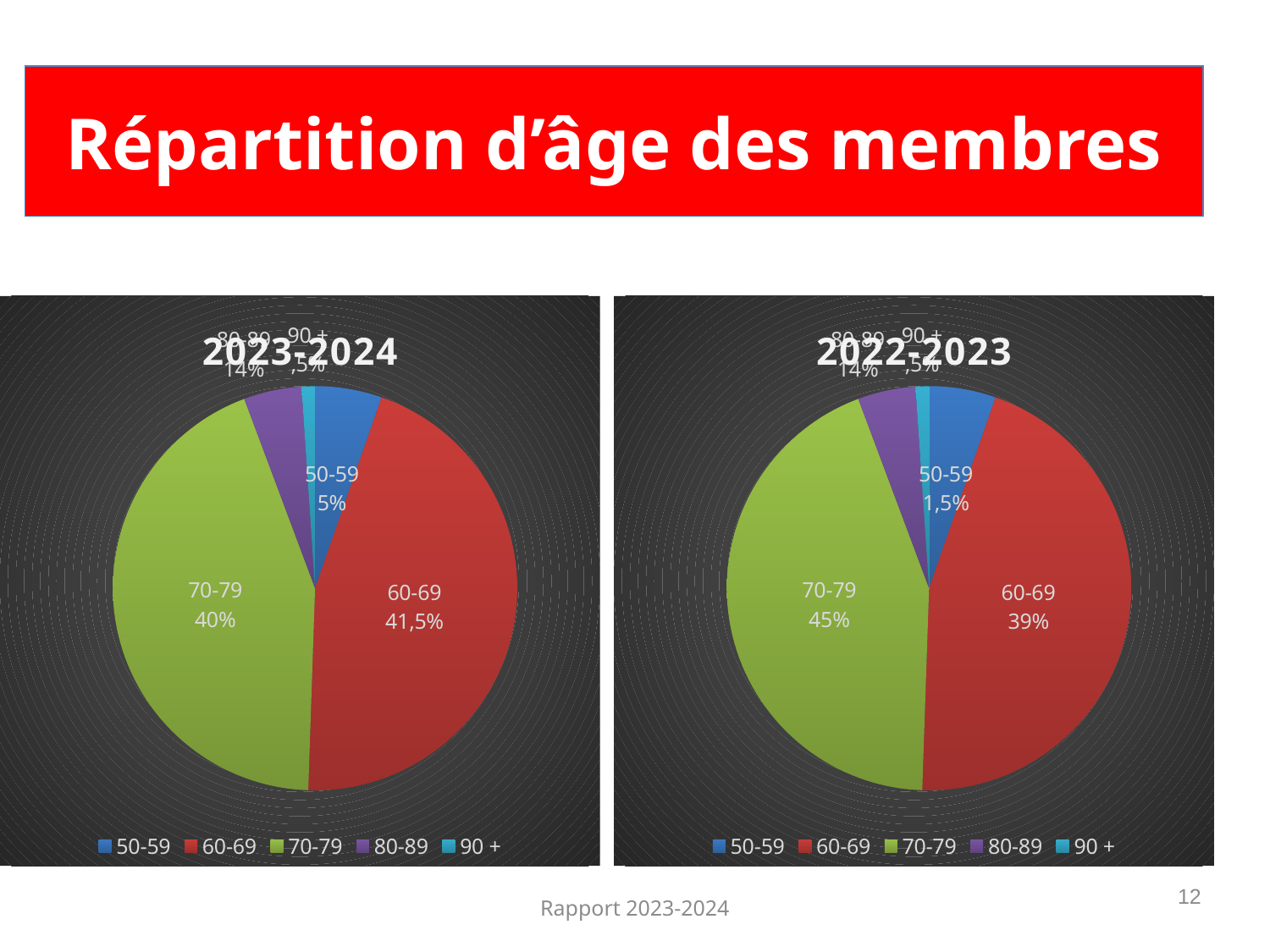
In the 2022-2023 chart, what percentage is shown for the 70-79 age group? 45% In the 2022-2023 chart, what percentage is shown for the 50-59 age group? 1,5% In the 2022-2023 chart, which is larger: the 60-69 slice or the 70-79 slice? 70-79 In the 2022-2023 chart, what percentage is shown for the 60-69 age group? 39% In the 2023-2024 chart, what percentage is shown for the 50-59 age group? 5% In the 2022-2023 chart, which age group has the largest share? 70-79 In the 2023-2024 chart, what percentage is shown for the 60-69 age group? 41,5% What type of chart is used on this slide? Pie chart How many age groups does the legend of the 2022-2023 chart list? 5 In the 2023-2024 chart, what is the difference between the 60-69 share and the 70-79 share? 1,5% In the 2023-2024 chart, what percentage is shown for the 70-79 age group? 40% In the 2023-2024 chart, which age group has the largest share? 60-69